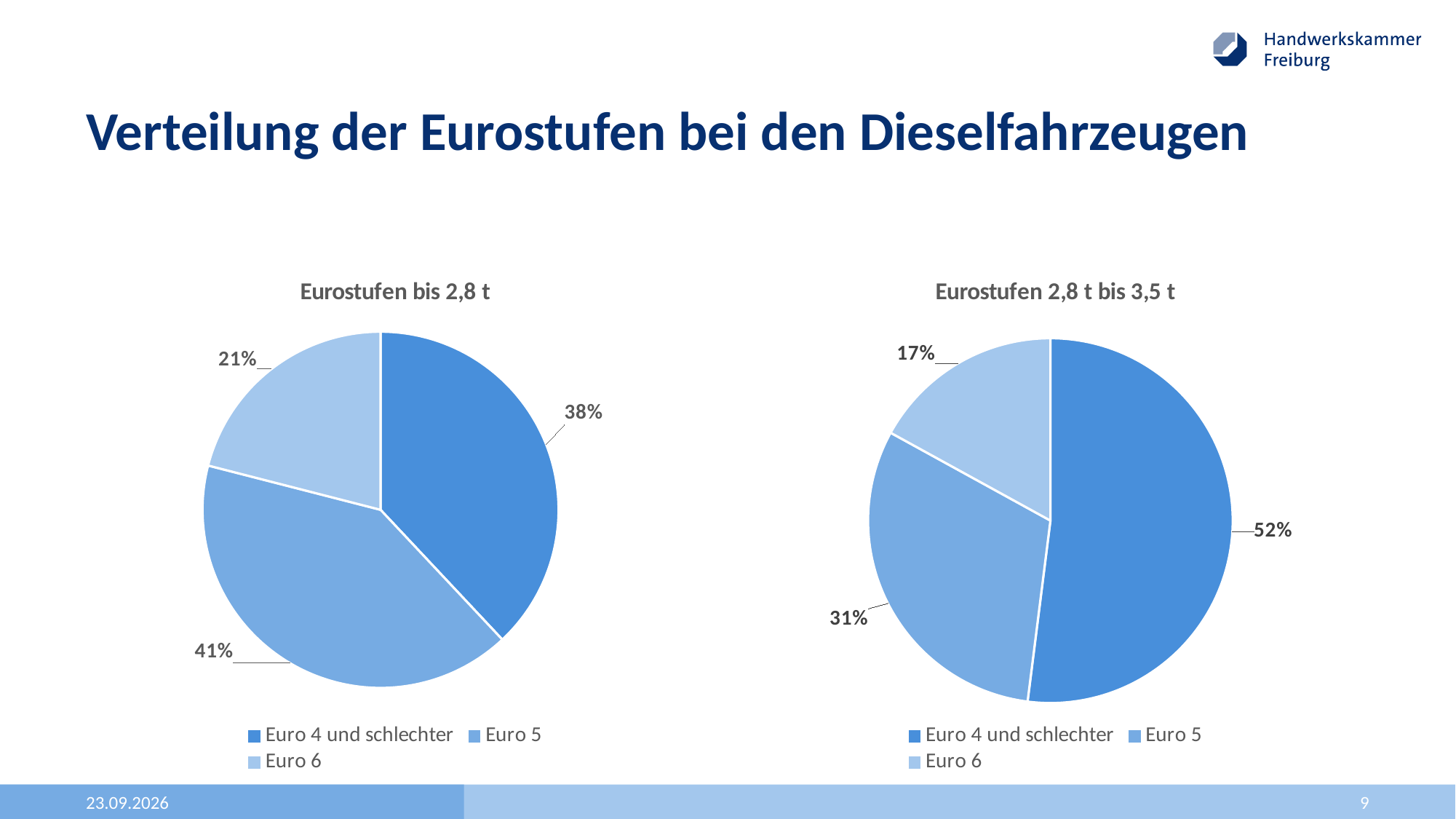
How many categories does the 'Eurostufen bis 2,8 t' chart show? 3 In the 'Eurostufen bis 2,8 t' chart, what share does Euro 5 have? 41% Which chart shows a larger share for 'Euro 4 und schlechter', 'Eurostufen bis 2,8 t' or 'Eurostufen 2,8 t bis 3,5 t'? Eurostufen 2,8 t bis 3,5 t In the 'Eurostufen 2,8 t bis 3,5 t' chart, which category has the smallest slice? Euro 6 What is the title of the chart on the left of the slide? Eurostufen bis 2,8 t In the 'Eurostufen bis 2,8 t' chart, what is the difference between the Euro 5 share and the Euro 6 share? 20 percentage points In the 'Eurostufen 2,8 t bis 3,5 t' chart, what share does Euro 6 have? 17% In the 'Eurostufen bis 2,8 t' chart, which category has the largest slice? Euro 5 In the 'Eurostufen 2,8 t bis 3,5 t' chart, what share does 'Euro 4 und schlechter' have? 52% In the 'Eurostufen 2,8 t bis 3,5 t' chart, what is the difference between the 'Euro 4 und schlechter' share and the Euro 5 share? 21 percentage points What kind of chart is the 'Eurostufen 2,8 t bis 3,5 t' chart? Pie chart In the 'Eurostufen bis 2,8 t' chart, what share does Euro 6 have? 21%